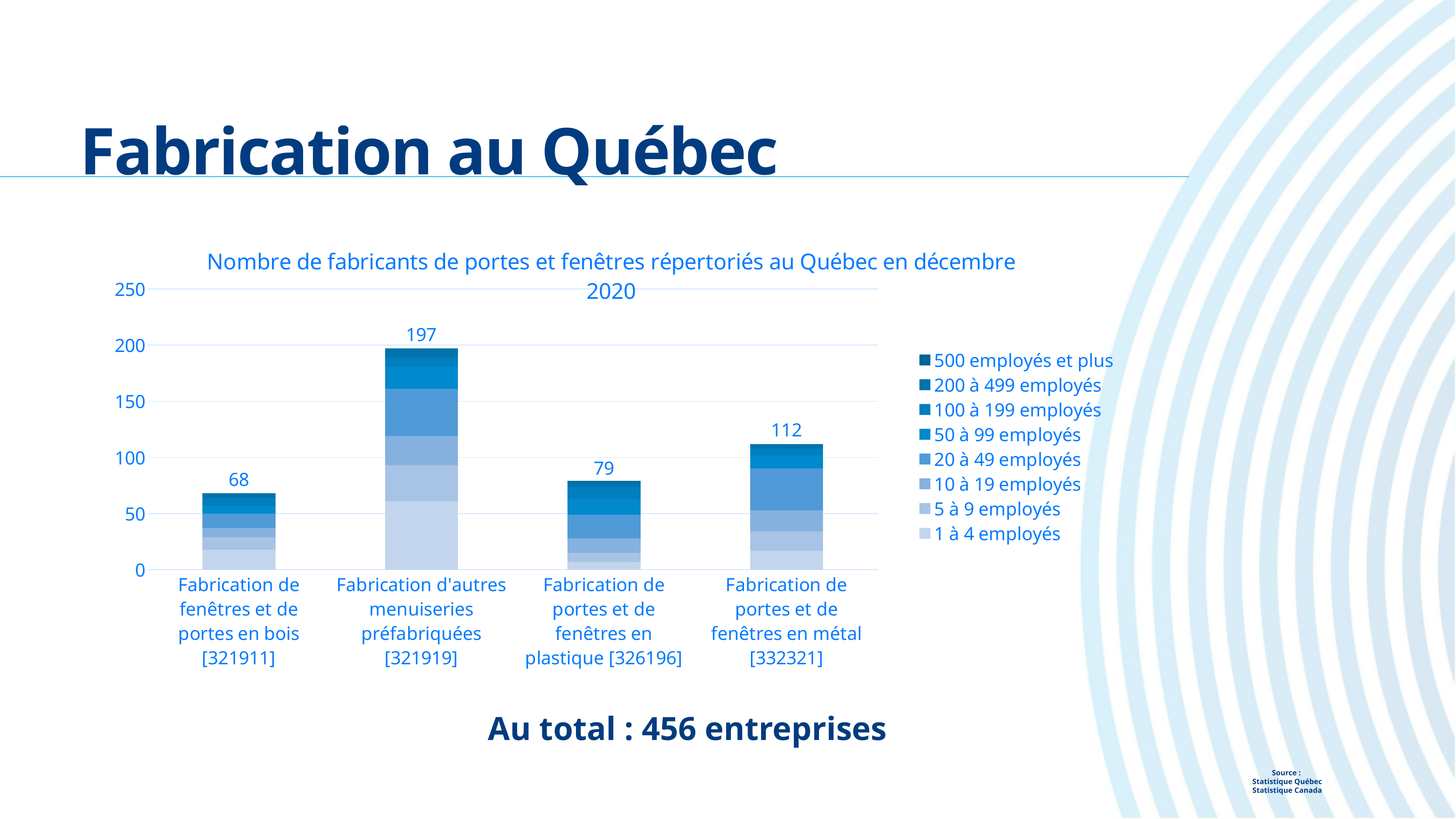
Which has a larger total: Fabrication de portes et de fenêtres en plastique [326196] or Fabrication de portes et de fenêtres en métal [332321]? Fabrication de portes et de fenêtres en métal [332321] What is the difference between the total for Fabrication d'autres menuiseries préfabriquées [321919] and the total for Fabrication de portes et de fenêtres en métal [332321]? 85 What is the total number of manufacturers shown for Fabrication d'autres menuiseries préfabriquées [321919]? 197 Which category has the highest total number of manufacturers? Fabrication d'autres menuiseries préfabriquées [321919] Which category has the lowest total number of manufacturers? Fabrication de fenêtres et de portes en bois [321911] How many categories are shown on the x axis of the chart? 4 What is the total number of manufacturers shown for Fabrication de portes et de fenêtres en métal [332321]? 112 How many series does the chart's legend list? 8 What is the title of the chart? Nombre de fabricants de portes et fenêtres répertoriés au Québec en décembre 2020 What is the total number of manufacturers shown for Fabrication de fenêtres et de portes en bois [321911]? 68 What kind of chart is shown on the slide? Stacked bar chart